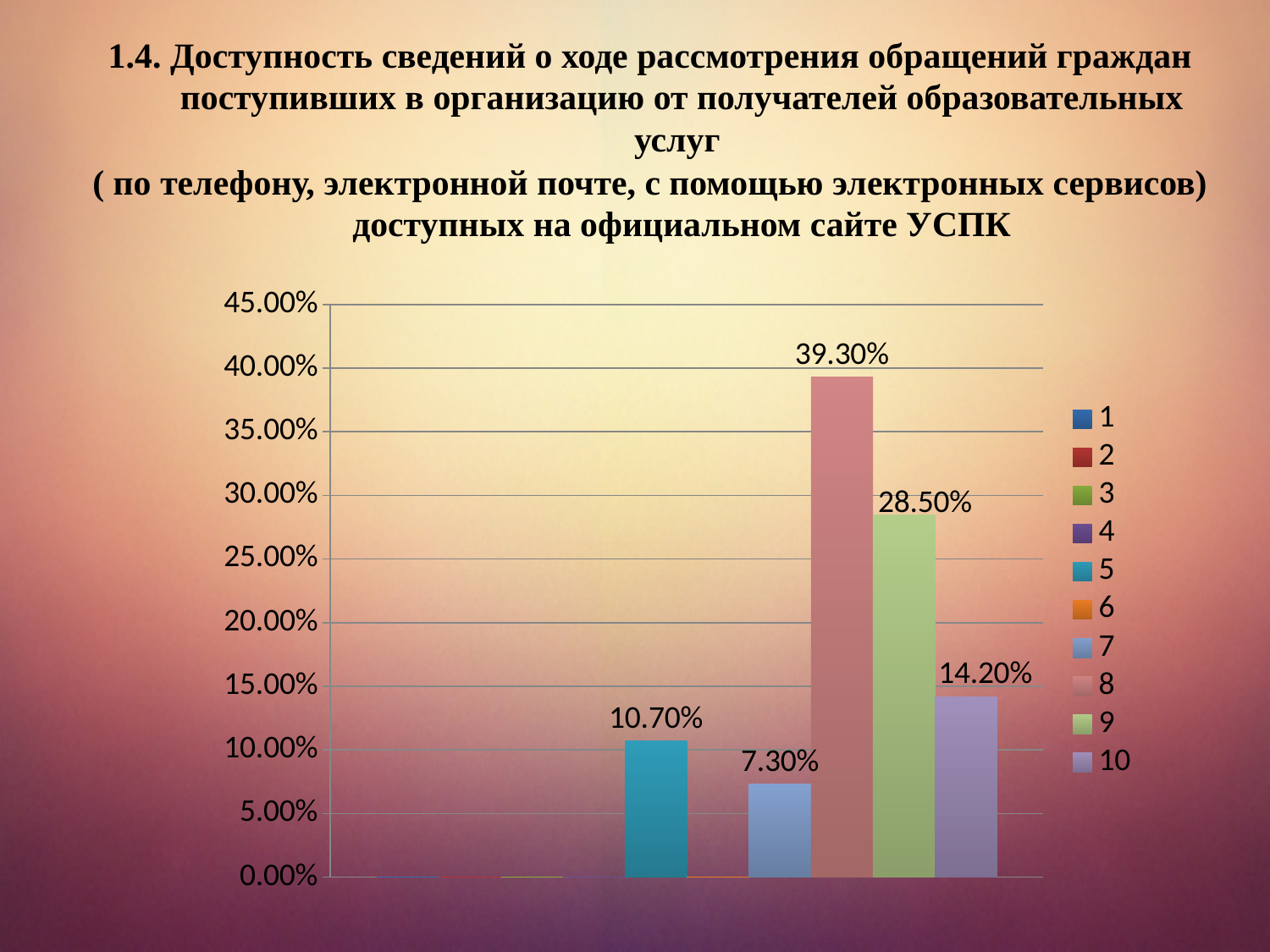
Is the value for series 10 greater or less than 15.00%? less Which series has the highest value? 8 What is the value for series 5? 10.70% What is the value for series 9? 28.50% What type of chart is shown on the slide? bar chart What is the difference between the values for series 8 and series 9? 10.80% What is the highest value shown on the vertical axis? 45.00% What is the value for series 7? 7.30% How many series does the legend list? 10 Which is larger, the value for series 5 or the value for series 7? series 5 What is the value for series 10? 14.20% What is the value for series 8? 39.30%